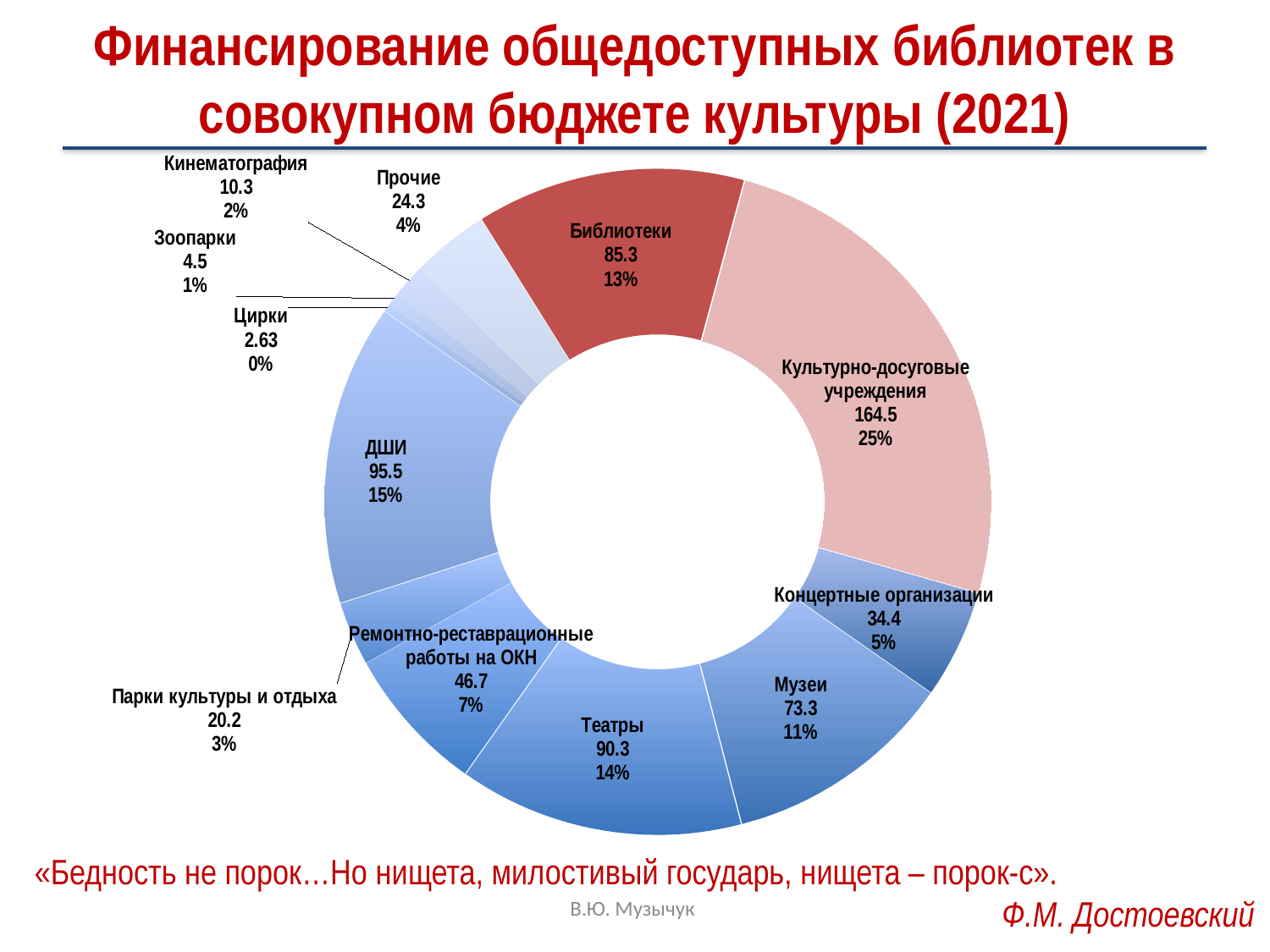
What is the difference between the values for ДШИ and Библиотеки? 10.2 What is the title of the slide containing the chart? Финансирование общедоступных библиотек в совокупном бюджете культуры (2021) What value is shown for Зоопарки? 4.5 What percentage share is shown for Культурно-досуговые учреждения? 25% What value is shown for Театры? 90.3 Which category has the largest value? Культурно-досуговые учреждения Which is larger, the value for Музеи or the value for Концертные организации? Музеи Which category has the smallest value? Цирки What percentage share is shown for Ремонтно-реставрационные работы на ОКН? 7% How many categories are shown in the chart? 12 What value is shown for Библиотеки? 85.3 What kind of chart is shown on the slide? Doughnut (pie) chart